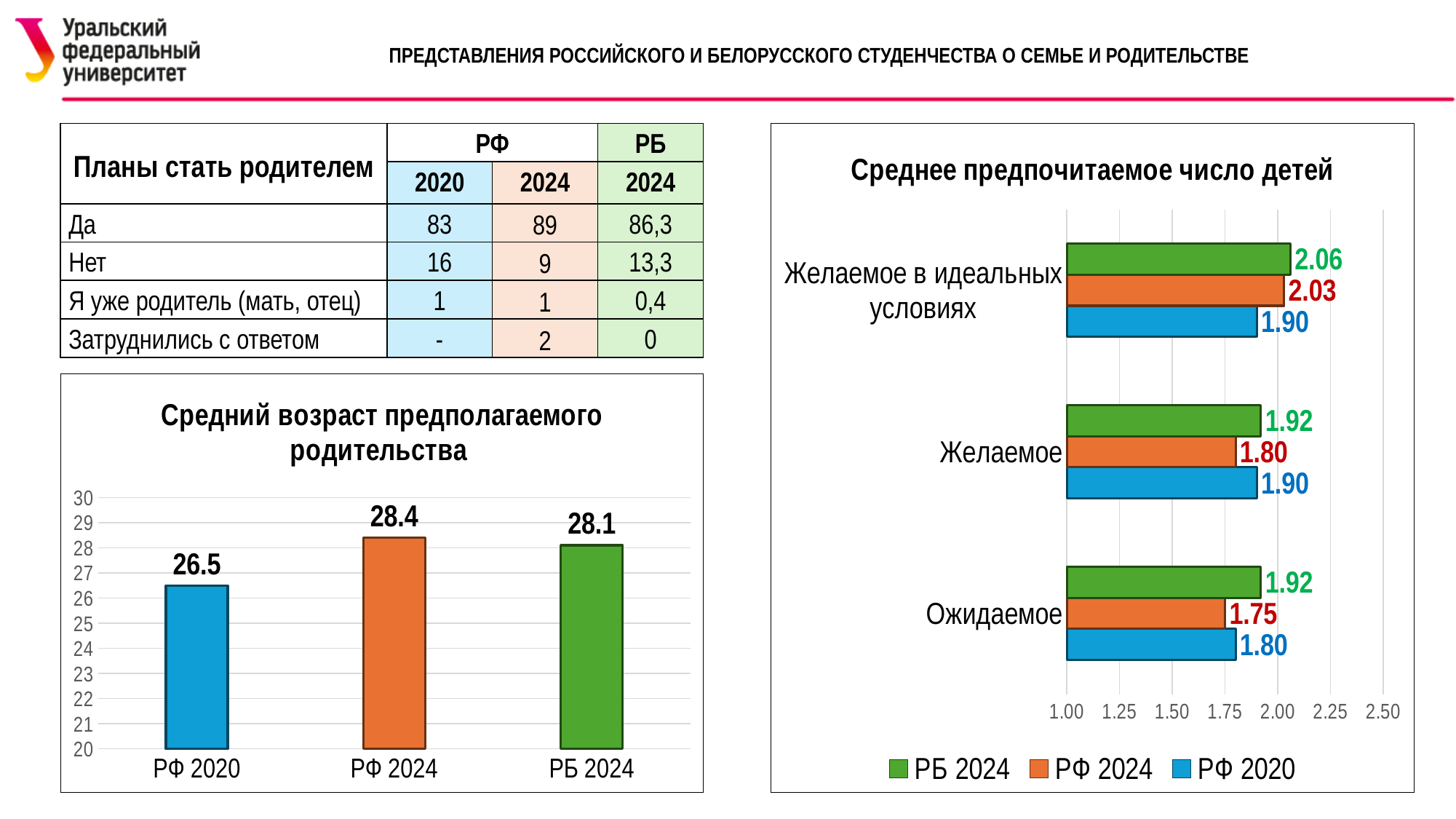
In the chart 'Среднее предпочитаемое число детей', how many series does the legend list? 3 In the chart 'Средний возраст предполагаемого родительства', which category has the lowest value? РФ 2020 In the chart 'Средний возраст предполагаемого родительства', what is the difference between РФ 2024 and РФ 2020? 1.9 In the chart 'Среднее предпочитаемое число детей', what is the difference between РБ 2024 and РФ 2020 in the category 'Ожидаемое'? 0.12 In the chart 'Среднее предпочитаемое число детей', what is the value for РФ 2024 in the category 'Ожидаемое'? 1.75 In the chart 'Среднее предпочитаемое число детей', which series has the highest value in the category 'Желаемое'? РБ 2024 In the chart 'Средний возраст предполагаемого родительства', what is the value for РФ 2024? 28.4 In the chart 'Средний возраст предполагаемого родительства', how many bars are plotted? 3 In the chart 'Среднее предпочитаемое число детей', which is larger for РФ 2020: 'Желаемое' or 'Ожидаемое'? Желаемое In the chart 'Среднее предпочитаемое число детей', what is the value for РБ 2024 in the category 'Желаемое в идеальных условиях'? 2.06 What kind of chart is 'Средний возраст предполагаемого родительства'? Bar chart In the chart 'Среднее предпочитаемое число детей', which colour represents the series РФ 2020? Blue